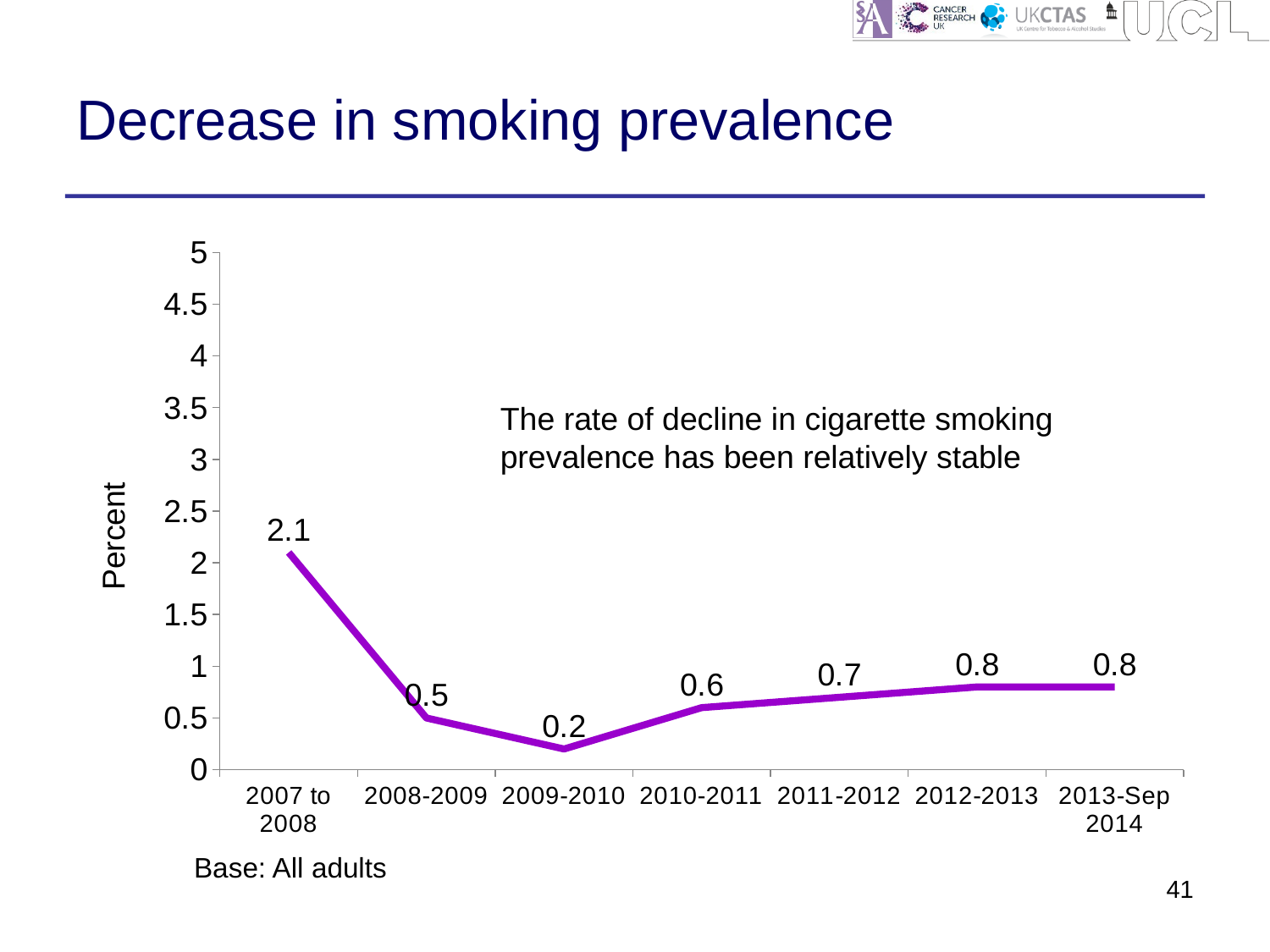
Which is larger, the value for 2010-2011 or the value for 2012-2013? 2012-2013 How many periods are plotted on the x axis? 7 Which period has the highest value? 2007 to 2008 Do the values rise or fall from 2009-2010 to 2012-2013? rise What is the value for 2009-2010? 0.2 What kind of chart is shown? line chart What is the value for 2007 to 2008? 2.1 What is the value for 2011-2012? 0.7 What is the label on the y axis? Percent What is the difference between the values for 2007 to 2008 and 2008-2009? 1.6 What is the value for 2013-Sep 2014? 0.8 Which period has the lowest value? 2009-2010